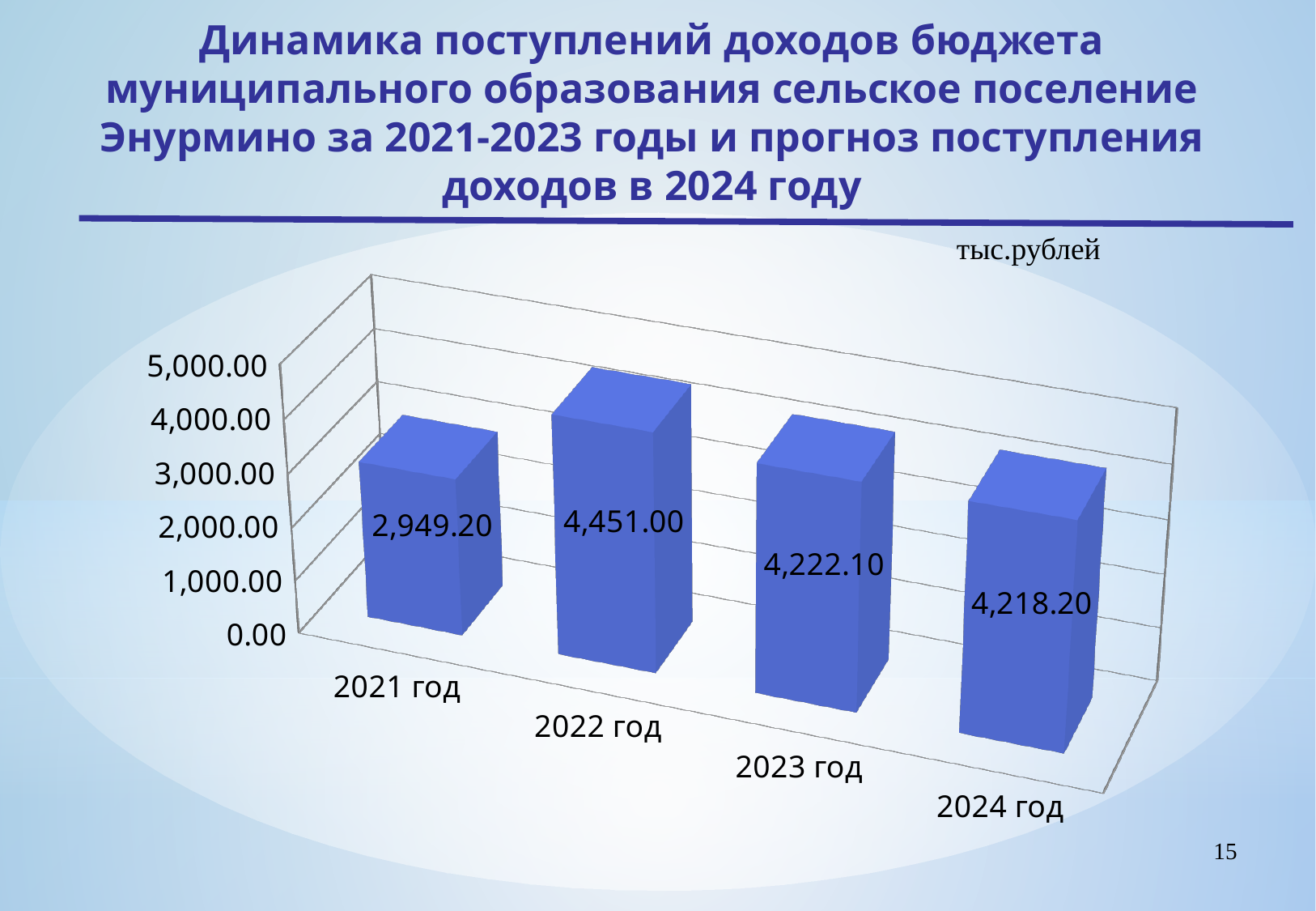
What is the forecast value for 2024 год? 4,218.20 Which is larger, the value for 2022 год or the value for 2023 год? 2022 год What is the difference between the values for 2022 год and 2021 год? 1,501.80 What is the difference between the values for 2023 год and 2024 год? 3.90 What is the value for 2022 год? 4,451.00 Which year has the lowest value? 2021 год What is the value for 2021 год? 2,949.20 What kind of chart is shown on the slide? bar chart What is the value for 2023 год? 4,222.10 Is the value for 2022 год greater or less than 4,000.00? greater Which year has the highest value? 2022 год How many years are shown on the chart? 4